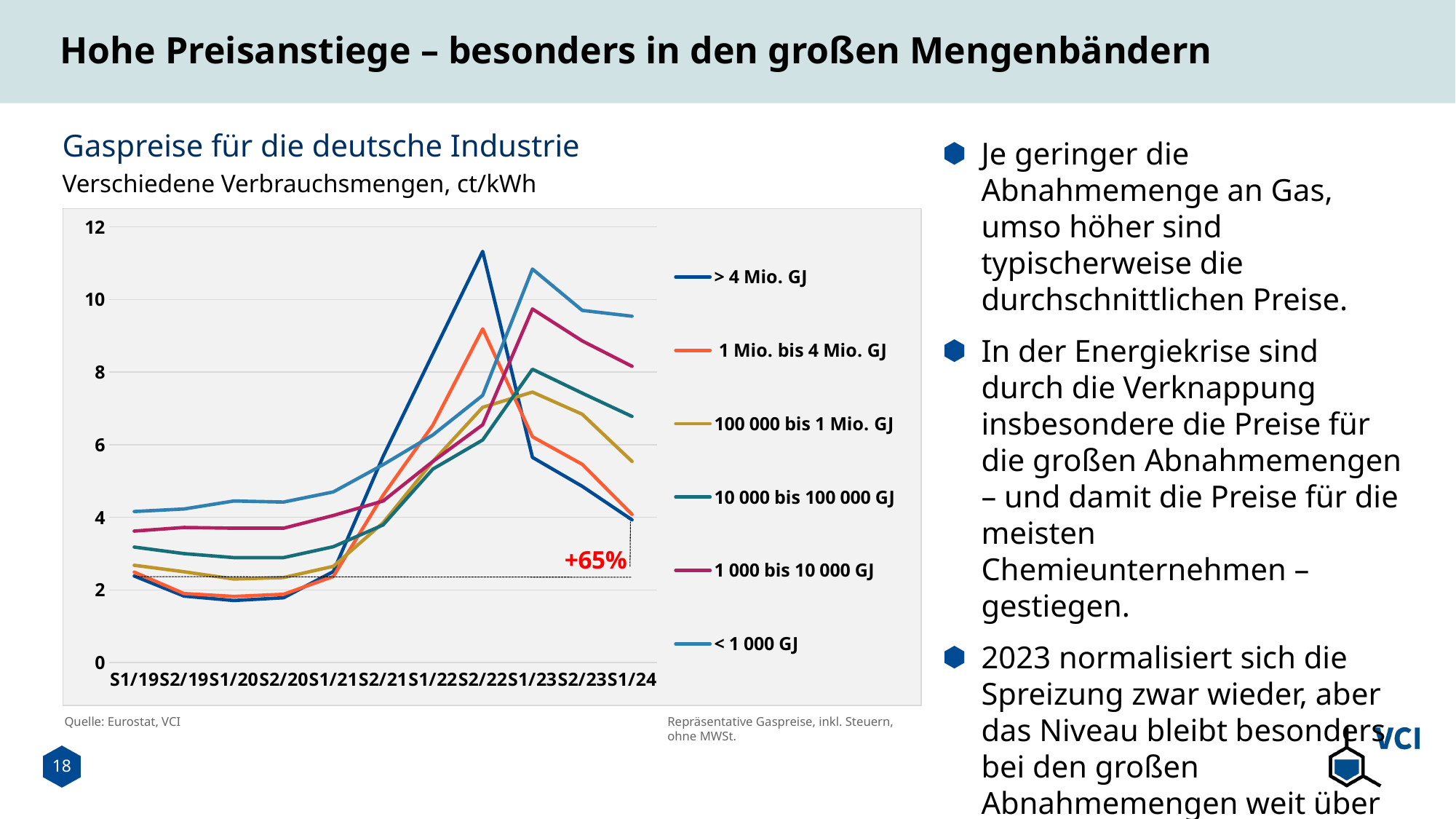
Is the value for '< 1 000 GJ' in S1/21 greater or less than 4? greater How many time periods are shown on the x axis of the chart? 11 In S1/24, which series is higher: '< 1 000 GJ' or '> 4 Mio. GJ'? < 1 000 GJ In which period does the '< 1 000 GJ' series reach its peak? S1/23 How many series does the legend of the chart list? 6 In which period does the '> 4 Mio. GJ' series reach its peak? S2/22 Is the value for '> 4 Mio. GJ' in S1/20 greater or less than 2? less What percentage change is annotated in red on the chart? +65% What kind of chart is shown on the slide? line chart Does the '> 4 Mio. GJ' series rise or fall from S1/22 to S1/24? fall Which series reaches the highest value anywhere on the chart? > 4 Mio. GJ Is the value for '> 4 Mio. GJ' in S1/22 greater or less than 10? less